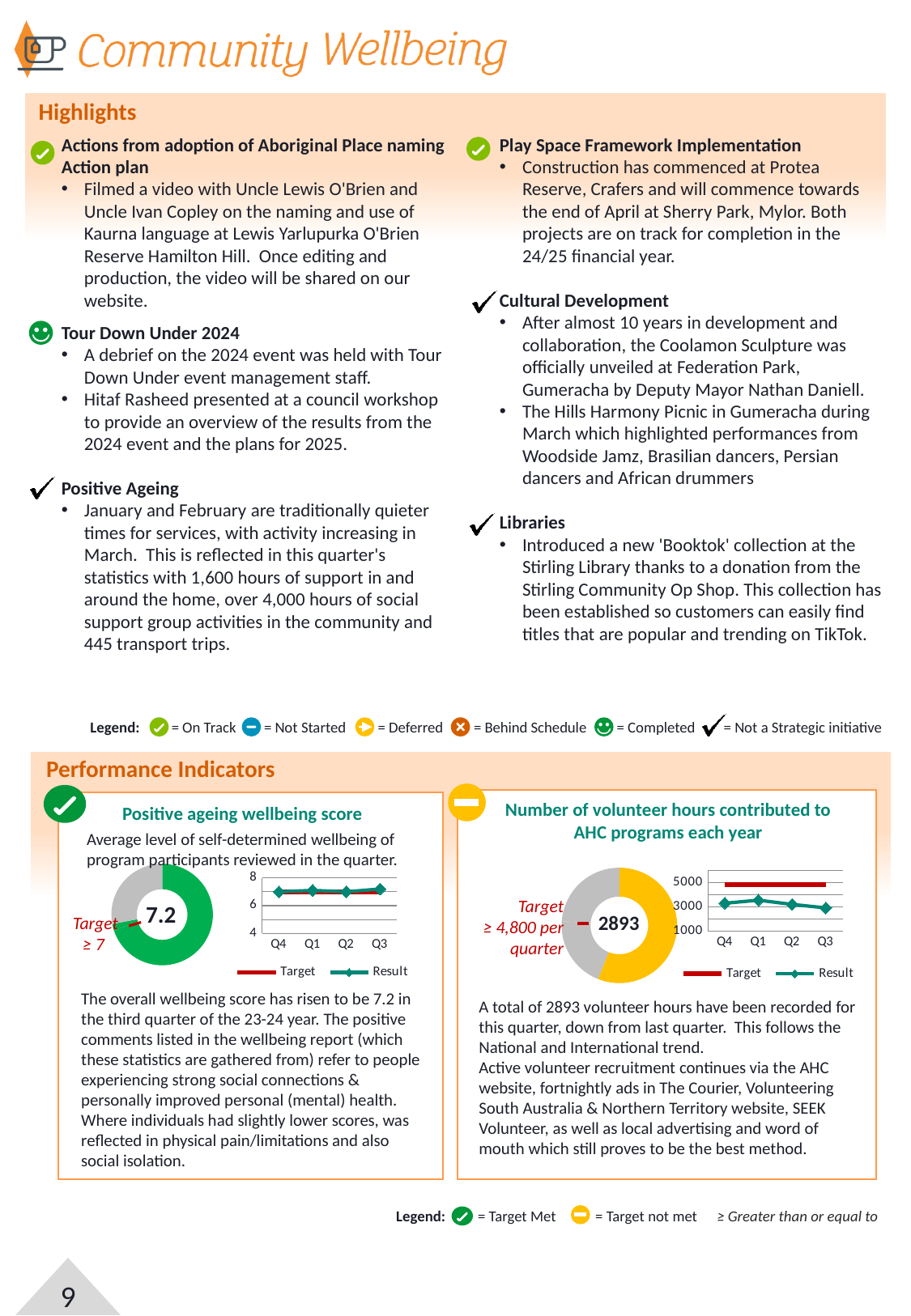
On the Number of volunteer hours line chart, does the Result line rise or fall from Q1 to Q3? fall On the Number of volunteer hours line chart, how many quarters are shown on the x axis? 4 On the Positive ageing wellbeing score chart, what is the target shown? ≥ 7 On the Number of volunteer hours line chart, which is higher at Q3, Target or Result? Target On the Number of volunteer hours line chart, is the Target value greater or less than 3000? greater On the Positive ageing wellbeing score line chart, how many series does the legend list? 2 What kind of chart shows the Target and Result by quarter on the Positive ageing wellbeing score panel? Line chart On the Positive ageing wellbeing score line chart, what colour is the Target line in the legend? Red On the Number of volunteer hours contributed to AHC programs each year chart, what is the target shown? ≥ 4,800 per quarter On the Positive ageing wellbeing score chart, what value is shown in the centre of the donut? 7.2 On the Positive ageing wellbeing score line chart, is the Result for Q3 greater or less than 6? greater On the Number of volunteer hours contributed to AHC programs each year chart, what value is shown in the centre of the donut? 2893